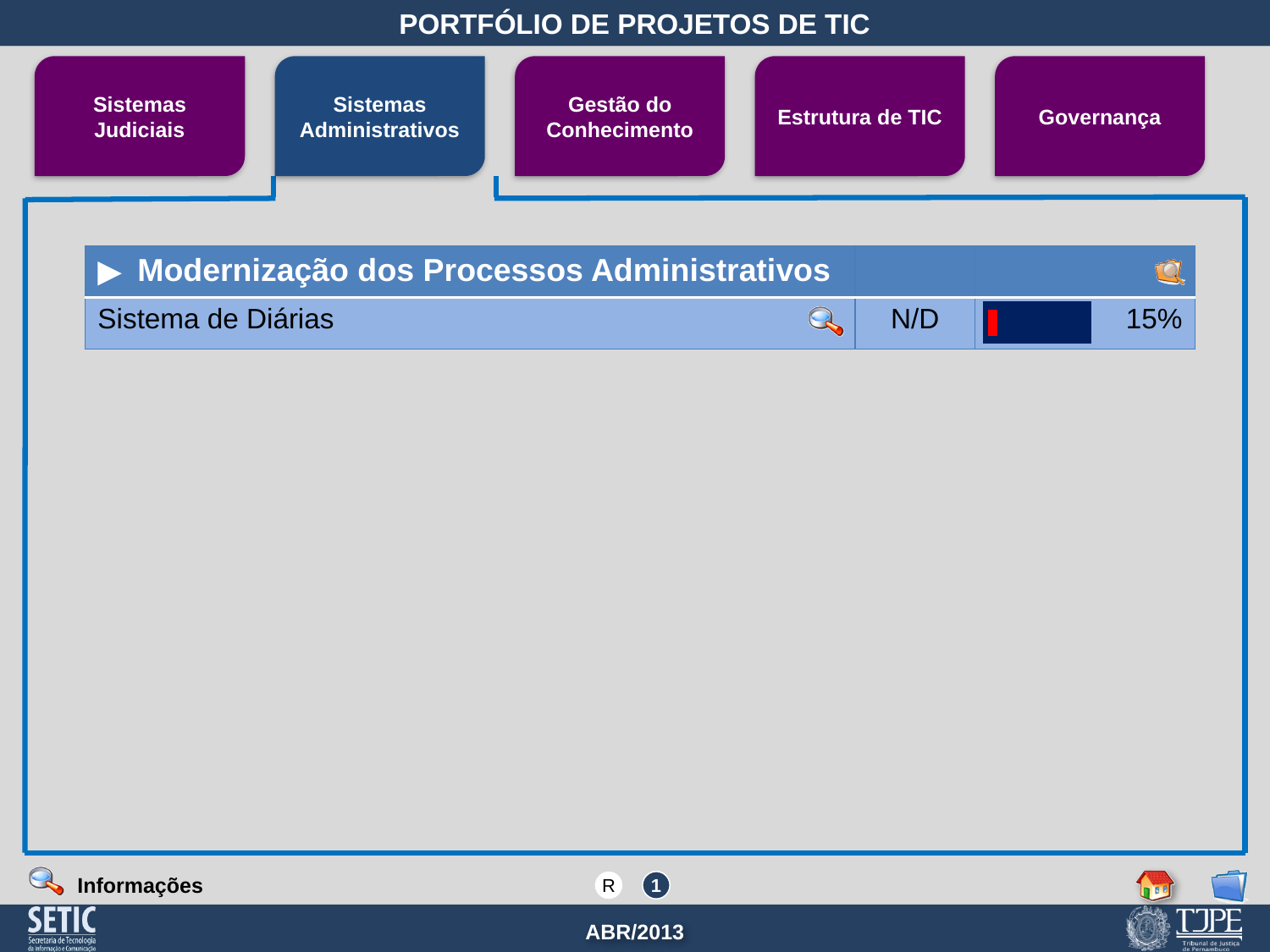
What is the title of the group that contains the Sistema de Diárias progress bar? Modernização dos Processos Administrativos What value is shown in the column to the left of the progress bar for Sistema de Diárias? N/D Is the progress value for Sistema de Diárias greater or less than 50%? less What colour is the filled portion of the progress bar for Sistema de Diárias? red What completion percentage is shown for Sistema de Diárias? 15% How many projects are listed under Modernização dos Processos Administrativos? 1 What kind of chart is used to show the progress of Sistema de Diárias? bar chart